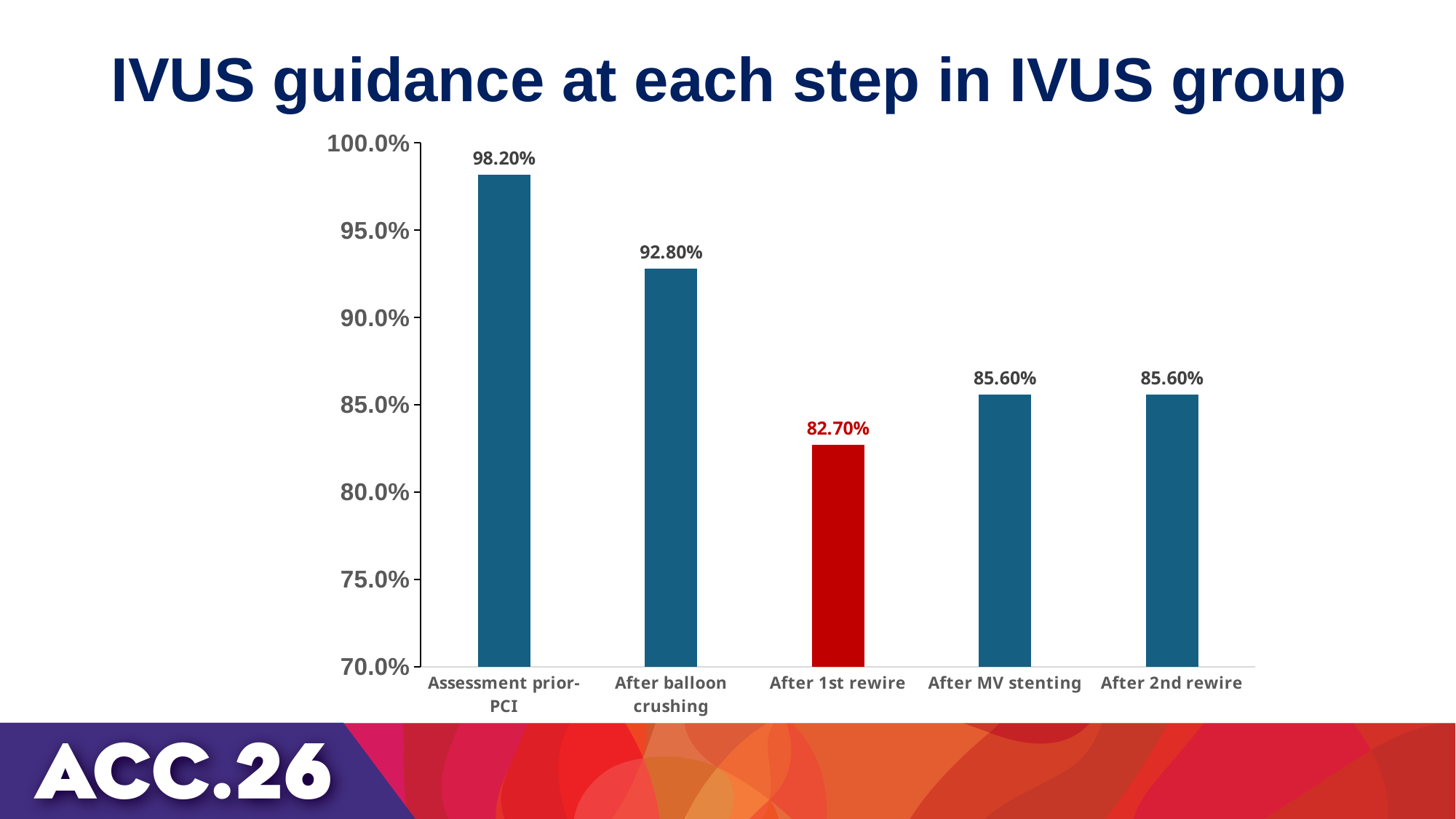
Which is larger, the value for After balloon crushing or the value for After 2nd rewire? After balloon crushing Which step has the highest value? Assessment prior-PCI What is the value for After balloon crushing? 92.80% How many steps are shown on the x axis? 5 Is the value for After 1st rewire greater or less than 85.0%? less What is the difference between the values for Assessment prior-PCI and After 1st rewire? 15.50% What kind of chart is shown on the slide? bar chart Which step has the lowest value? After 1st rewire Which bar is coloured red rather than blue? After 1st rewire What is the value for Assessment prior-PCI? 98.20% What is the value for After MV stenting? 85.60% What is the value for After 1st rewire? 82.70%